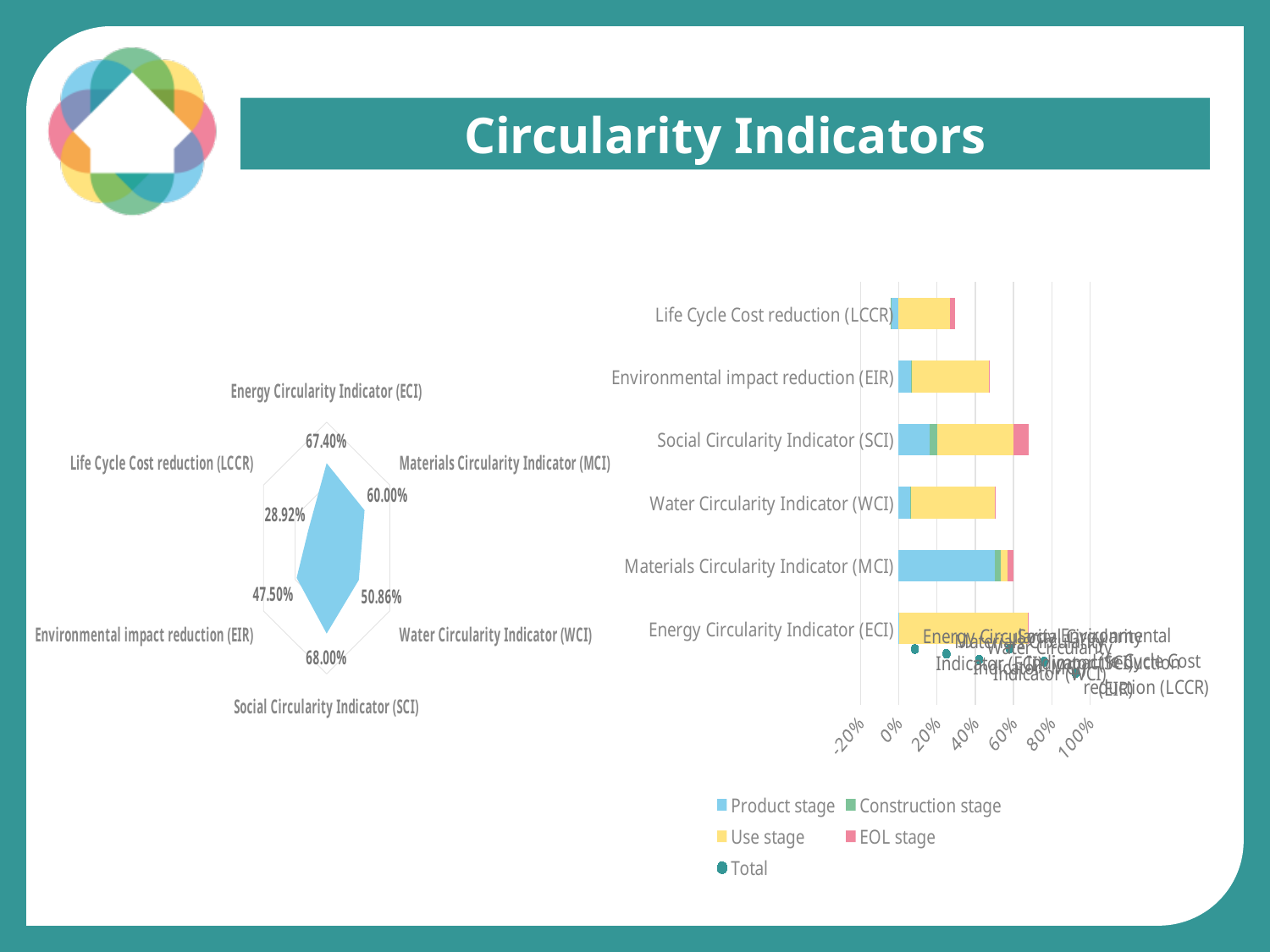
What kind of chart is the chart on the right of the slide? Stacked bar chart On the bar chart on the right, which legend entry is shown in yellow? Use stage On the radar chart on the left, which is larger: Materials Circularity Indicator (MCI) or Water Circularity Indicator (WCI)? Materials Circularity Indicator (MCI) On the radar chart on the left, what is the value for Energy Circularity Indicator (ECI)? 67.40% On the radar chart on the left, how many indicators are plotted? 6 On the radar chart on the left, which indicator has the lowest value? Life Cycle Cost reduction (LCCR) On the radar chart on the left, what is the value for Water Circularity Indicator (WCI)? 50.86% On the bar chart on the right, how many series does the legend list? 5 On the bar chart on the right, which category has the longest Product stage segment? Materials Circularity Indicator (MCI) On the radar chart on the left, which indicator has the highest value? Social Circularity Indicator (SCI) On the radar chart on the left, what is the difference between the Social Circularity Indicator (SCI) and the Environmental impact reduction (EIR) values? 20.50% On the radar chart on the left, what is the value for Life Cycle Cost reduction (LCCR)? 28.92%